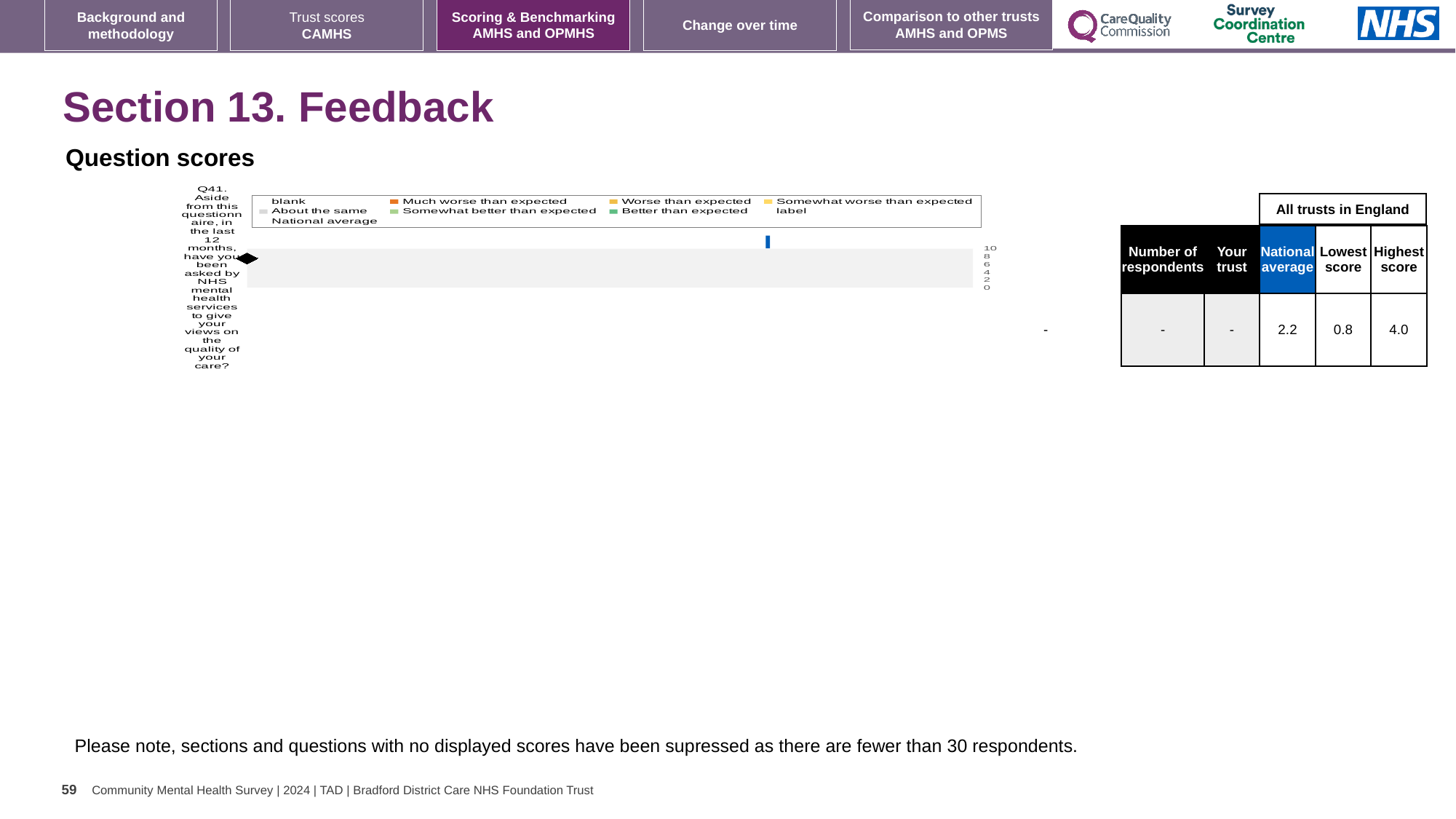
What kind of chart is shown on the slide? bar chart What is the highest value shown on the chart's axis? 10 How many entries does the chart legend list? 9 What is the lowest score across all trusts in England for Q41? 0.8 What is the national average score for Q41 shown in the table next to the chart? 2.2 How many question categories are plotted on the chart? 1 Which is larger for Q41, the national average or the lowest score? national average What is the highest score across all trusts in England for Q41? 4.0 What is the difference between the highest score and the lowest score for Q41? 3.2 Which question is plotted on the chart? Q41